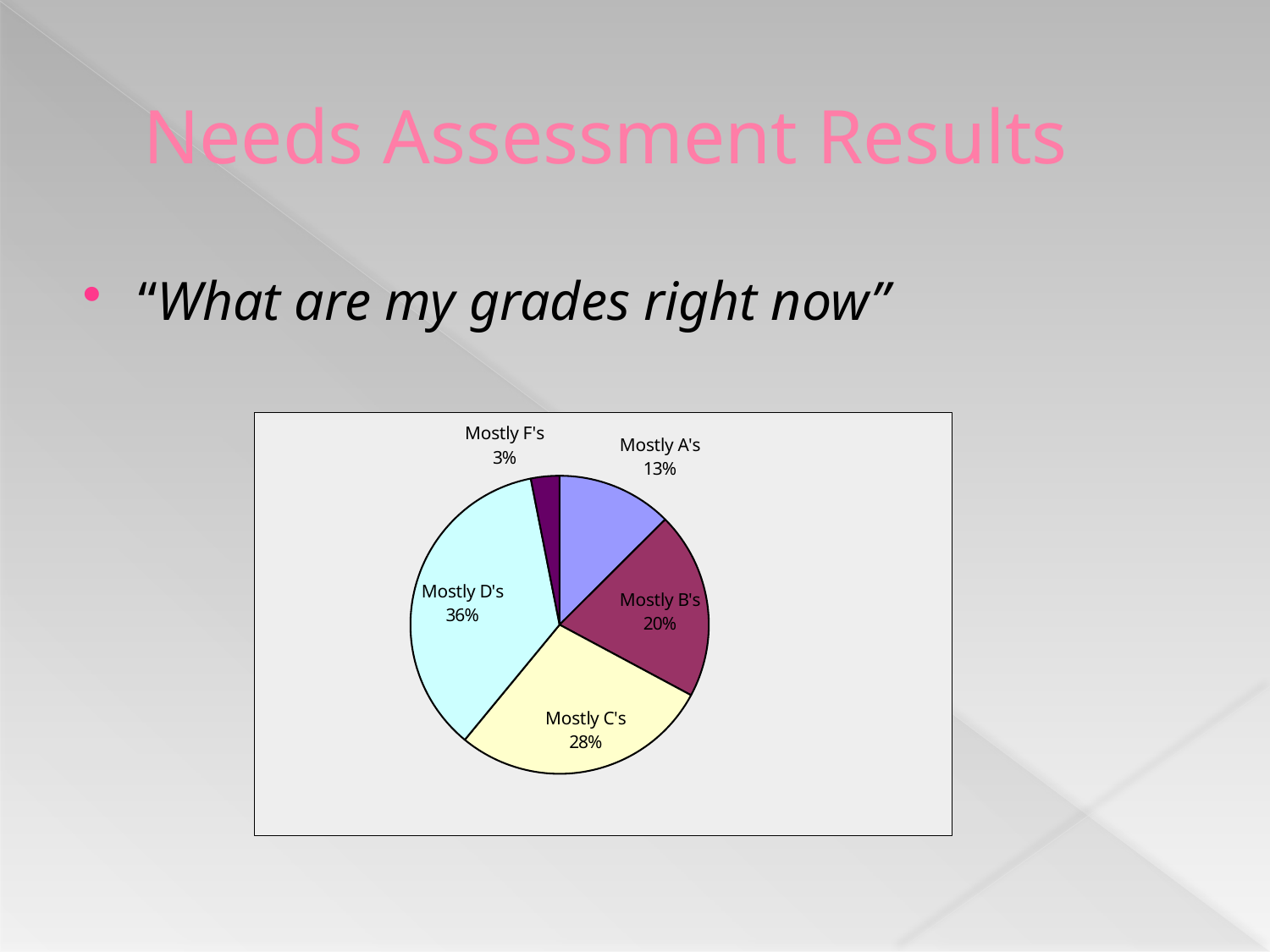
Which grade category has the largest share of the pie? Mostly D's What percentage of respondents reported Mostly F's? 3% What percentage of respondents reported Mostly A's? 13% What is the combined percentage for Mostly A's and Mostly B's? 33% What percentage of respondents reported Mostly C's? 28% How many slices does the pie chart have? 5 Which grade category has the smallest share of the pie? Mostly F's Which is larger, the share for Mostly C's or the share for Mostly B's? Mostly C's What kind of chart is shown on the slide? pie chart What percentage of respondents reported Mostly D's? 36% What is the difference in percentage points between Mostly D's and Mostly B's? 16 What survey question is the pie chart reporting results for? "What are my grades right now"